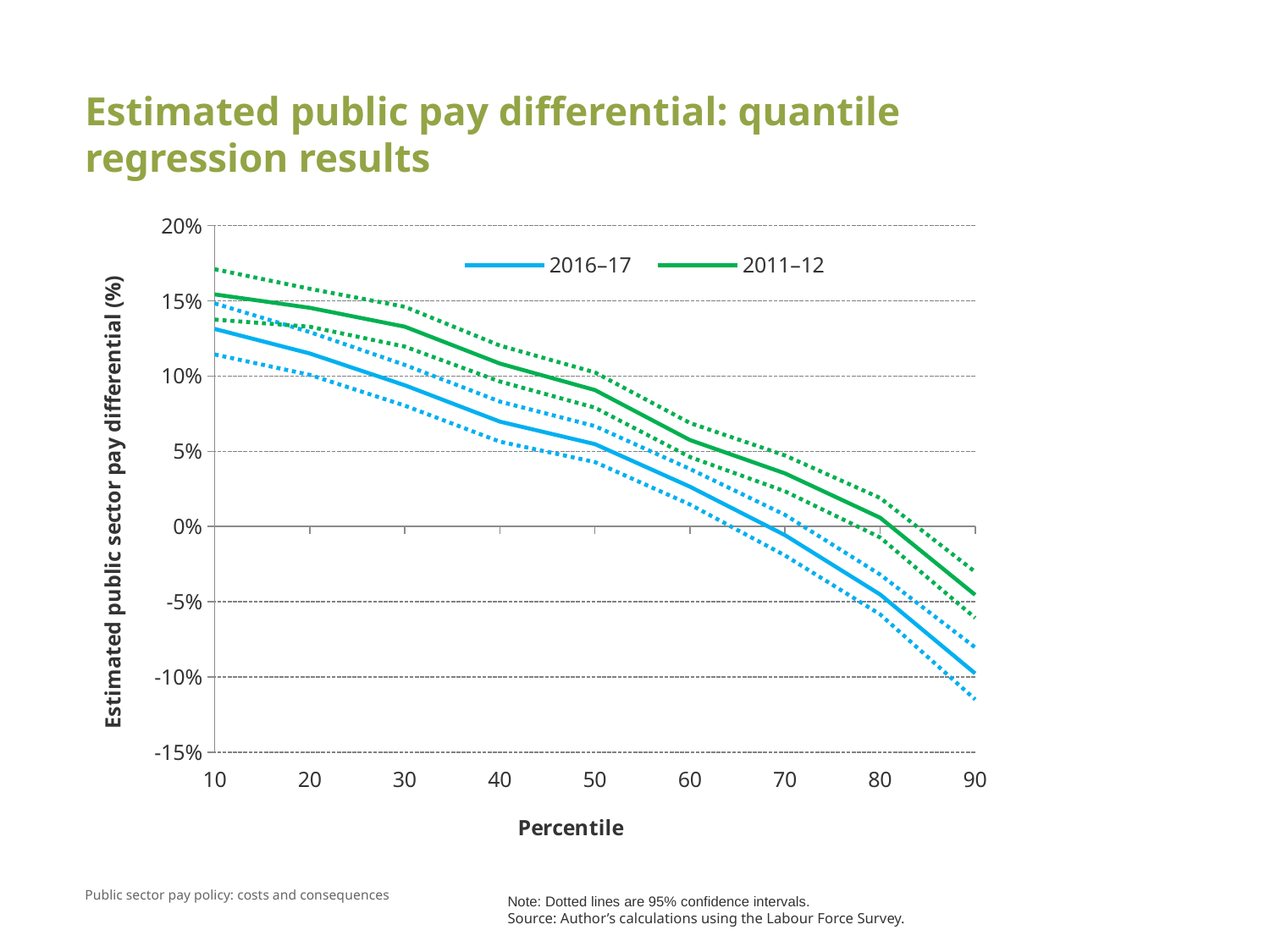
Is the value for 2011–12 at the 50th percentile greater or less than 5%? greater Do the values for 2011–12 rise or fall as the percentile increases from 10 to 90? fall Is the value for 2011–12 at the 90th percentile greater or less than 0%? less Is the value for 2011–12 at the 30th percentile greater or less than 10%? greater What kind of chart is shown on the slide? line chart How many series does the legend list? 2 At the 50th percentile, which series has the larger estimated public pay differential, 2016–17 or 2011–12? 2011–12 Which two series are listed in the legend? 2016–17 and 2011–12 Do the values for 2016–17 rise or fall as the percentile increases from 10 to 90? fall What is the label on the x axis? Percentile